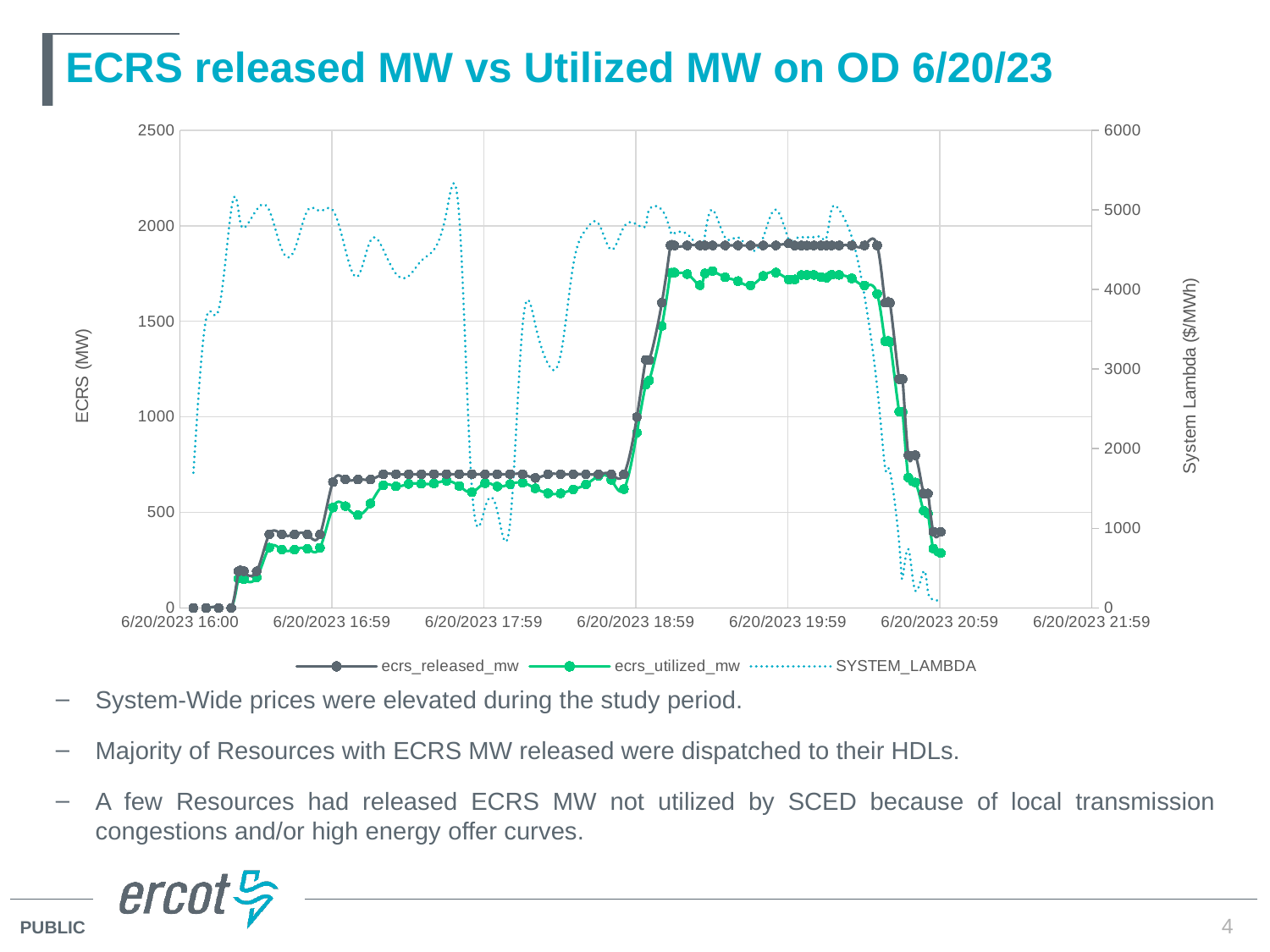
How many series does the chart legend list? 3 Is the value of ecrs_released_mw at 6/20/2023 19:59 greater or less than 1500? greater Does ecrs_utilized_mw rise or fall between 6/20/2023 19:59 and 6/20/2023 20:59? fall What is the value of ecrs_released_mw at 6/20/2023 16:00? 0 Does ecrs_released_mw rise or fall between 6/20/2023 16:00 and 6/20/2023 18:59? rise At 6/20/2023 19:59, which series has the larger value, ecrs_released_mw or ecrs_utilized_mw? ecrs_released_mw What is the title of the chart on the slide? ECRS released MW vs Utilized MW on OD 6/20/23 What kind of chart is shown on the slide? line chart What is the label of the right-hand vertical axis? System Lambda ($/MWh) Is the value of ecrs_utilized_mw at 6/20/2023 19:59 greater or less than 2000? less Is the value of ecrs_released_mw at 6/20/2023 17:59 greater or less than 1000? less